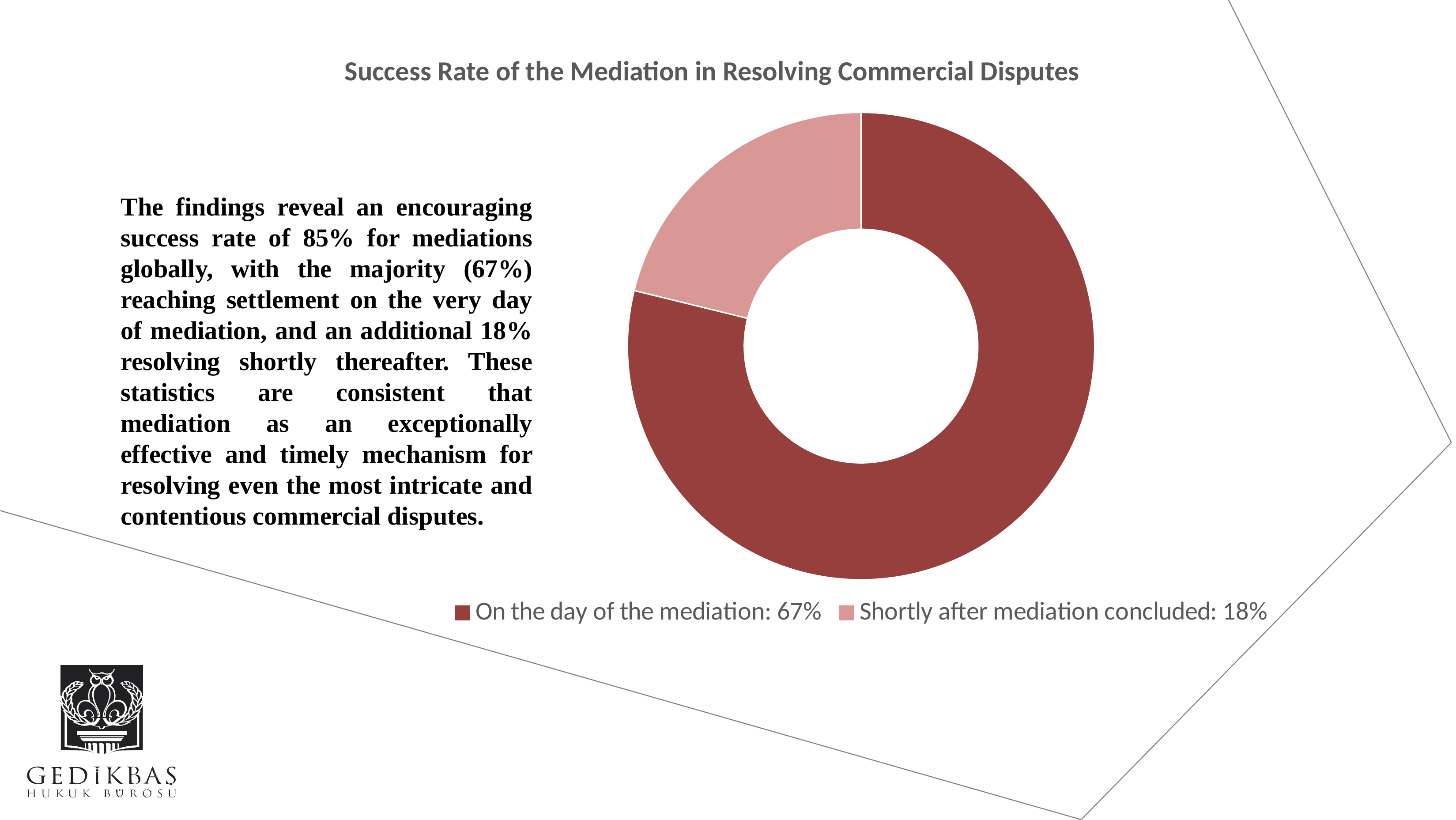
Which colour represents 'Shortly after mediation concluded: 18%' in the chart? Light pink What percentage of mediations resolved shortly after the mediation concluded, according to the chart? 18% By how many percentage points does the 'On the day of the mediation' value exceed the 'Shortly after mediation concluded' value? 49 percentage points What is the combined percentage of the two categories shown in the chart? 85% What percentage of mediations reached settlement on the day of the mediation, according to the chart? 67% What kind of chart is shown on the slide? Doughnut (pie) chart What is the title of the chart? Success Rate of the Mediation in Resolving Commercial Disputes Is the value for 'On the day of the mediation' larger or smaller than the value for 'Shortly after mediation concluded'? larger Which category has the larger slice in the chart? On the day of the mediation Which category has the smaller slice in the chart? Shortly after mediation concluded How many entries does the chart's legend list? 2 How many slices does the chart have? 2